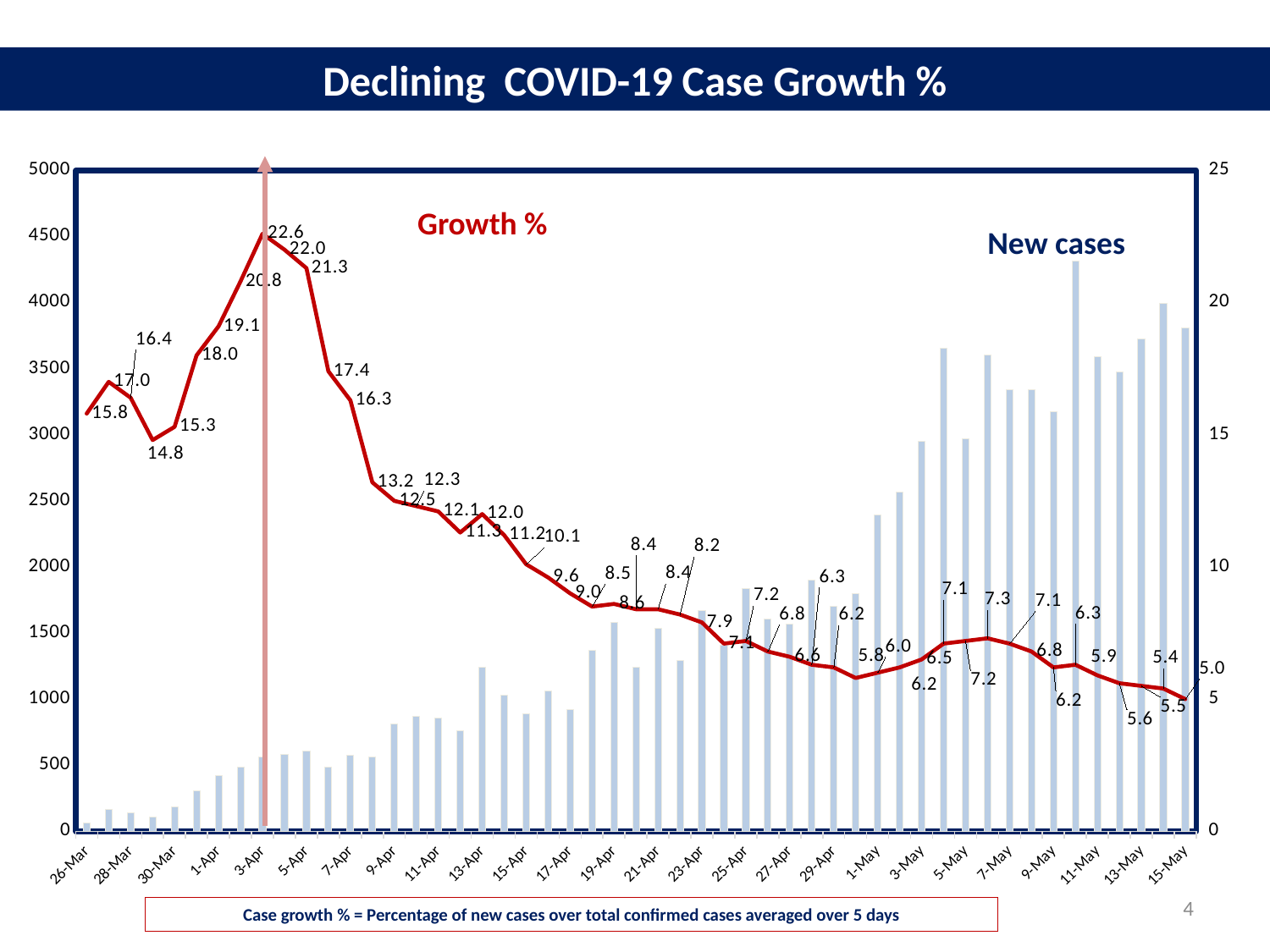
What is the Growth % value at the last point, 15-May? 5.0 Is the New cases bar for 11-May greater or less than 4000? less Is the New cases bar for 3-Apr greater or less than 1000? less What is the difference between the peak Growth % (22.6) and the final Growth % (5.0)? 17.6 What is the lowest Growth % value shown on the chart? 5.0 What is the title of the chart on the slide? Declining COVID-19 Case Growth % What is the highest Growth % value shown on the chart? 22.6 What is the Growth % value on 3-Apr, where the vertical arrow is placed? 22.6 Does the Growth % line rise or fall from 3-Apr to 15-May? Fall How many data series are plotted on the chart? 2 What kind of chart is shown on the slide? A combined bar and line chart What is the Growth % value at the first point, 26-Mar? 15.8